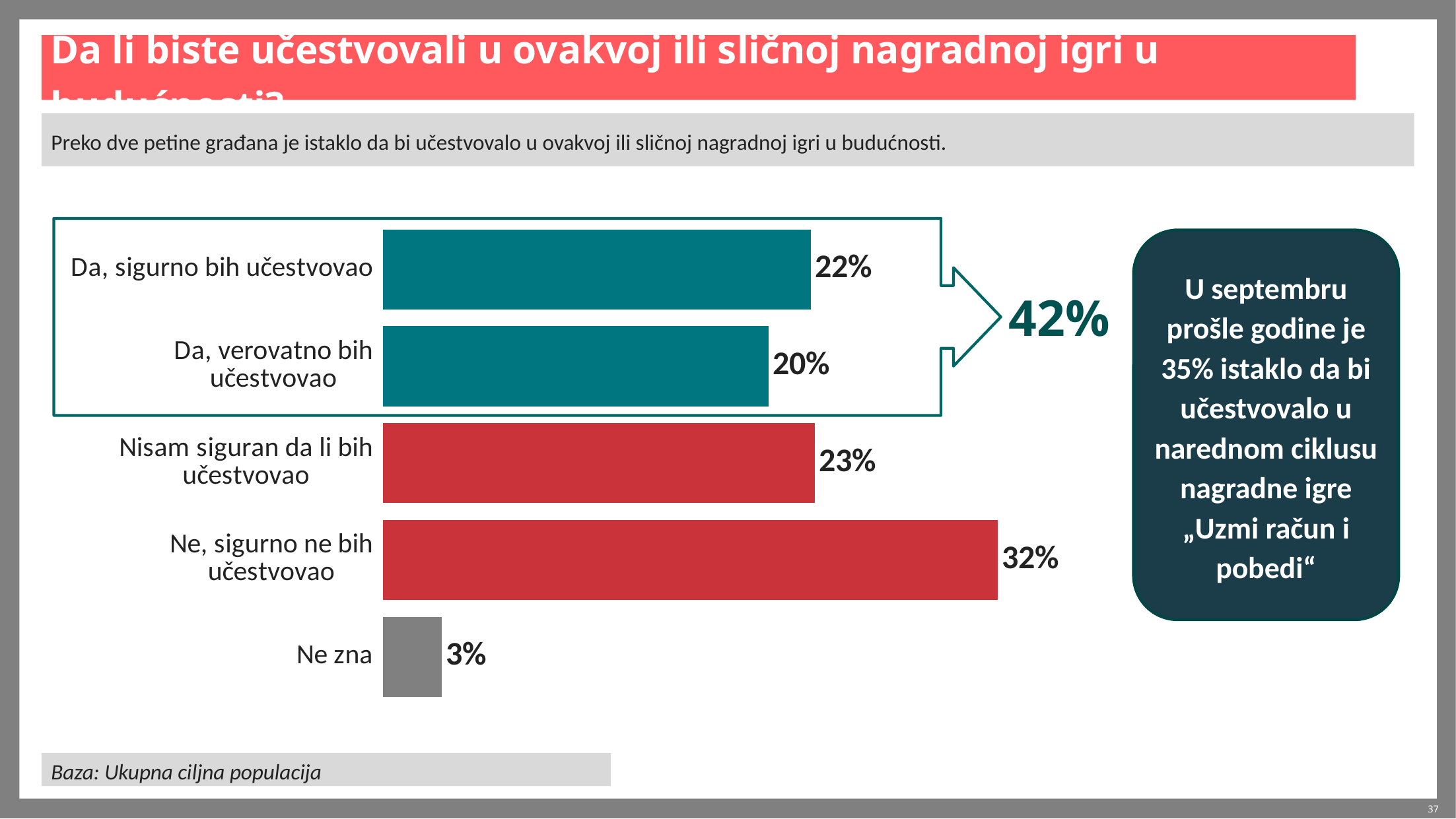
What kind of chart is shown on the slide? Bar chart What is the value for "Nisam siguran da li bih učestvovao"? 23% What is the value for "Ne zna"? 3% What is the value for "Da, verovatno bih učestvovao"? 20% What is the difference between "Ne, sigurno ne bih učestvovao" and "Da, sigurno bih učestvovao"? 10% Which category has the lowest value? Ne zna Which is larger: "Nisam siguran da li bih učestvovao" or "Da, verovatno bih učestvovao"? Nisam siguran da li bih učestvovao What is the value for "Ne, sigurno ne bih učestvovao"? 32% What combined percentage is shown in the arrow next to the two "Da" bars? 42% What is the value for "Da, sigurno bih učestvovao"? 22% Which category has the highest value? Ne, sigurno ne bih učestvovao How many categories are shown in the chart? 5